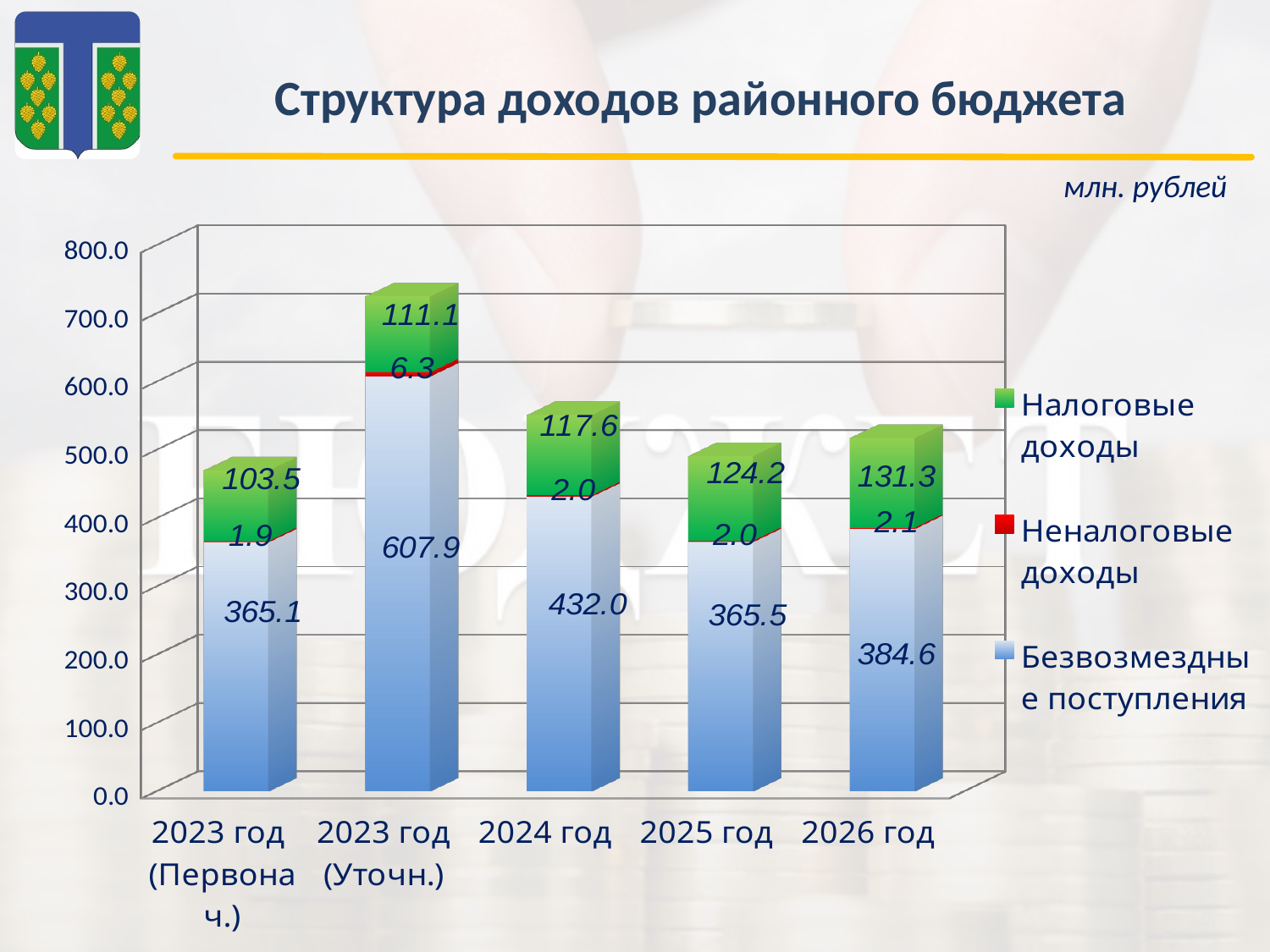
What is the total of the stacked bar for 2024 год? 551.6 What is the value of Налоговые доходы for 2026 год? 131.3 Which category has the lowest value of Налоговые доходы? 2023 год (Первонач.) What is the value of Неналоговые доходы for 2023 год (Уточн.)? 6.3 Which is larger: Безвозмездные поступления for 2024 год or for 2026 год? 2024 год How many categories are shown on the x axis? 5 What is the value of Безвозмездные поступления for 2023 год (Уточн.)? 607.9 Do the values of Налоговые доходы rise or fall from 2023 год (Первонач.) to 2026 год? Rise How many series does the legend list? 3 What type of chart is shown on the slide? Stacked bar chart Which category has the highest value of Безвозмездные поступления? 2023 год (Уточн.) What is the difference between Налоговые доходы for 2026 год and for 2025 год? 7.1